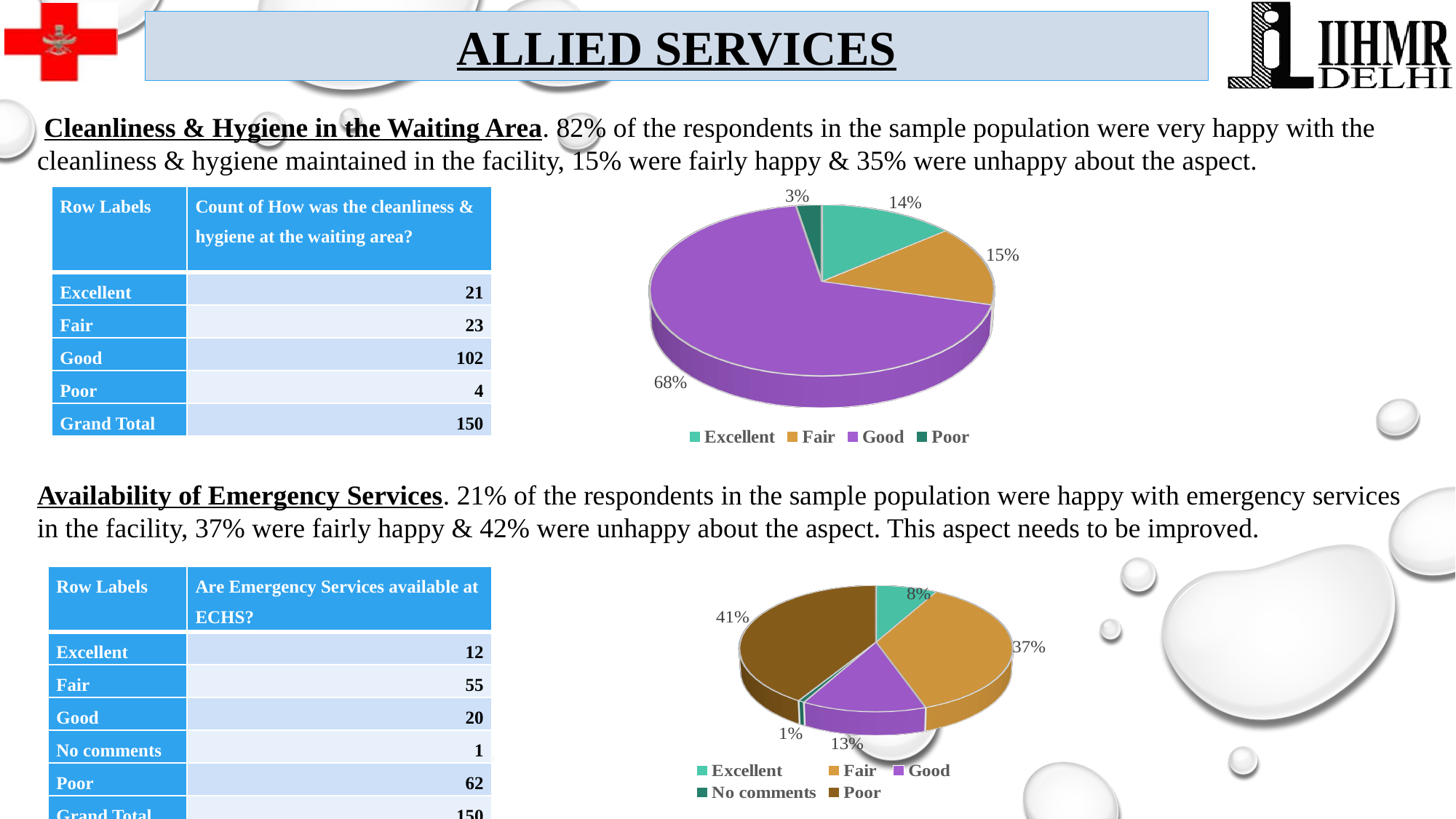
In the bottom pie chart (Availability of Emergency Services), what percentage is shown for Poor? 41% In the bottom pie chart (Availability of Emergency Services), which category has the smallest slice? No comments In the top pie chart (Cleanliness & Hygiene in the Waiting Area), which category has the smallest slice? Poor In the top pie chart (Cleanliness & Hygiene in the Waiting Area), which category has the largest slice? Good What type of chart is the top chart on the slide? Pie chart In the bottom pie chart (Availability of Emergency Services), which is larger, Excellent or Good? Good In the bottom pie chart (Availability of Emergency Services), how many categories does the legend list? 5 In the bottom pie chart (Availability of Emergency Services), what percentage is shown for Fair? 37% In the top pie chart (Cleanliness & Hygiene in the Waiting Area), what share of the pie is labelled Good? 68% In the bottom pie chart (Availability of Emergency Services), what is the difference in percentage points between Poor and Good? 28 In the top pie chart (Cleanliness & Hygiene in the Waiting Area), what percentage is shown for Fair? 15% In the top pie chart (Cleanliness & Hygiene in the Waiting Area), how many categories does the legend list? 4